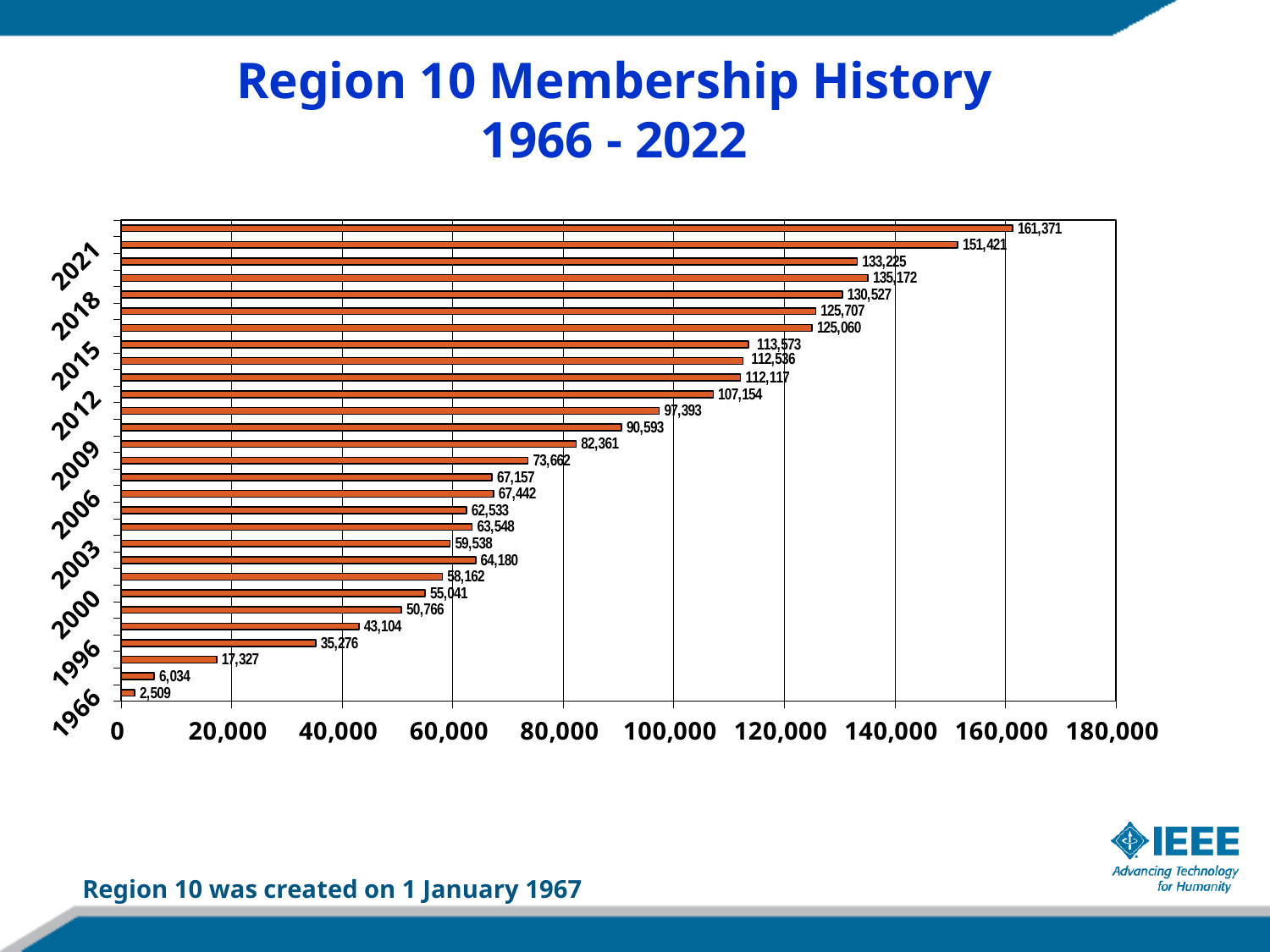
What is the lowest membership value shown in the chart? 2,509 What kind of chart is shown on the slide? bar chart Do membership values generally rise or fall from the 1966 bar at the bottom to the top bar? rise Which is larger, the bar labelled 133,225 or the bar labelled 135,172? 135,172 What is the largest value shown on the horizontal axis? 180,000 What is the membership value for 1966, the bottom bar of the chart? 2,509 What is the highest membership value shown in the chart? 161,371 What is the difference between the second bar from the bottom (6,034) and the bottom bar (2,509)? 3,525 Is the value of the longest bar greater or less than 160,000? greater How many bars are plotted in the chart? 29 What is the title of the chart? Region 10 Membership History 1966 - 2022 What is the difference between the top bar (161,371) and the bar directly below it (151,421)? 9,950